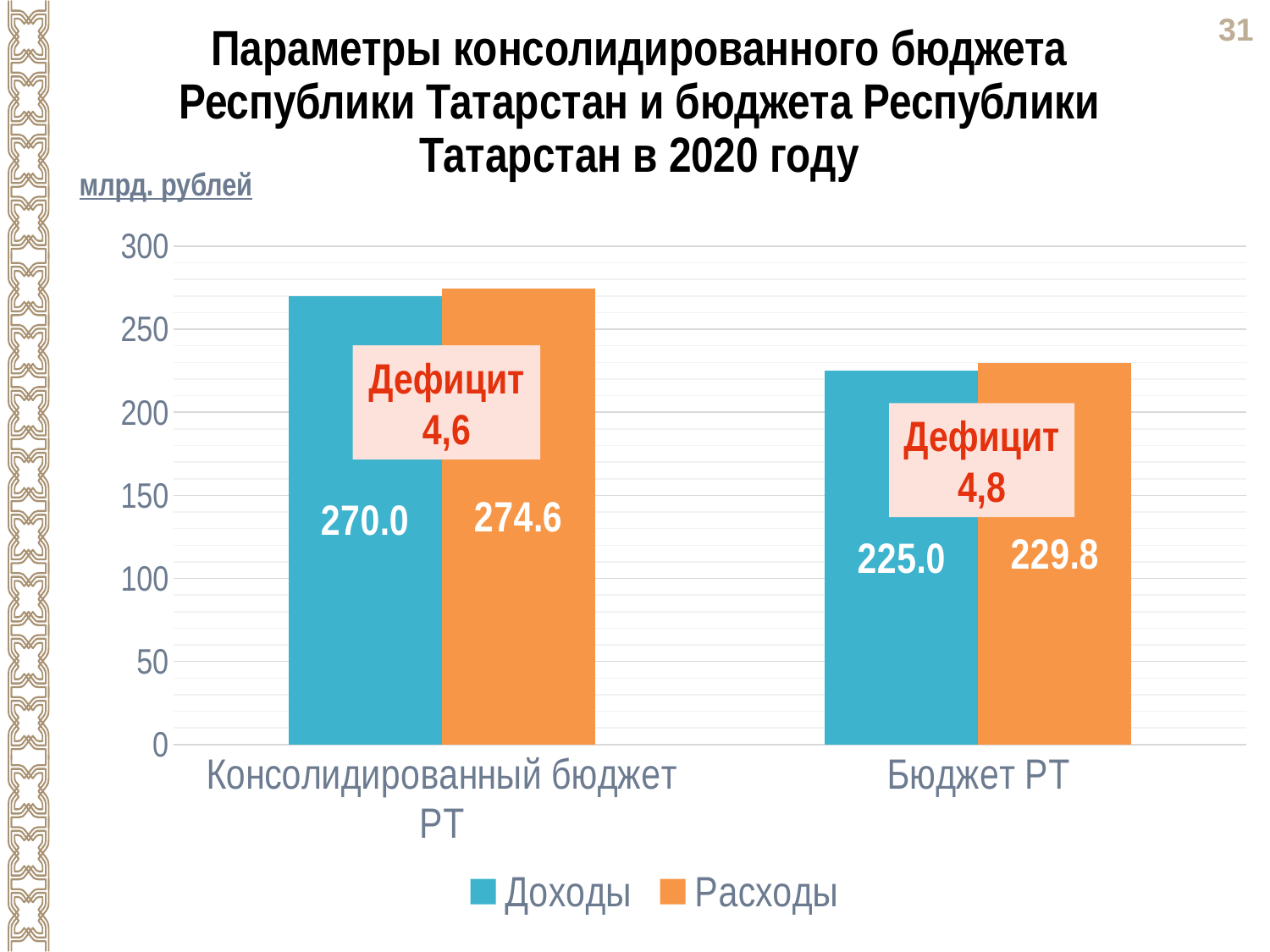
Which category has the higher Расходы value? Консолидированный бюджет РТ What is the value of Расходы for Консолидированный бюджет РТ? 274.6 What kind of chart is shown on the slide? Bar chart How many categories are shown on the x axis? 2 What is the value of Доходы for Бюджет РТ? 225.0 For Бюджет РТ, which is larger: Доходы or Расходы? Расходы How many series does the legend list? 2 What is the value of Расходы for Бюджет РТ? 229.8 What is the value of Доходы for Консолидированный бюджет РТ? 270.0 What is the difference between Расходы and Доходы for Бюджет РТ? 4.8 Which category has the lower Доходы value? Бюджет РТ What is the difference between Расходы and Доходы for Консолидированный бюджет РТ? 4.6